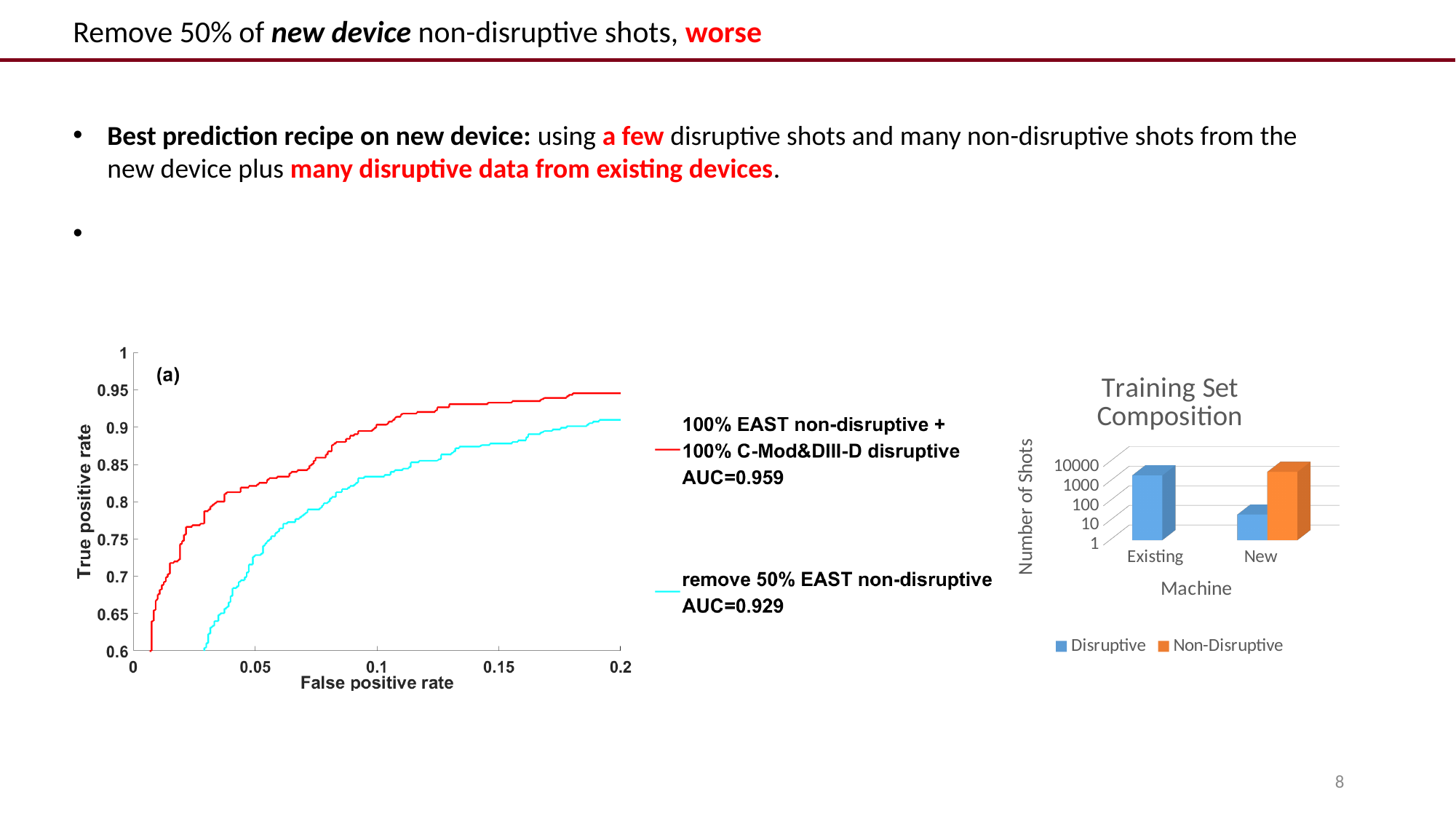
In the 'Training Set Composition' chart, which machine has more Disruptive shots, Existing or New? Existing In the 'Training Set Composition' chart, is the number of Disruptive shots for New greater or less than 100? less What kind of chart is the 'Training Set Composition' chart on the right of the slide? bar chart What is the y-axis label of the 'Training Set Composition' chart? Number of Shots In the ROC chart on the left, what is the difference between the AUC values of the two curves? 0.030 How many machine categories are shown on the x axis of the 'Training Set Composition' chart? 2 In the ROC chart on the left, what is the AUC of the red curve (100% EAST non-disruptive + 100% C-Mod&DIII-D disruptive)? 0.959 In the 'Training Set Composition' chart, which series has more shots for the New machine, Disruptive or Non-Disruptive? Non-Disruptive In the ROC chart on the left, does the true positive rate rise or fall as the false positive rate increases? rise In the 'Training Set Composition' chart, is the number of Disruptive shots for Existing greater or less than 1000? greater How many series does the legend of the 'Training Set Composition' chart list? 2 In the ROC chart on the left, what is the AUC of the curve for 'remove 50% EAST non-disruptive'? 0.929